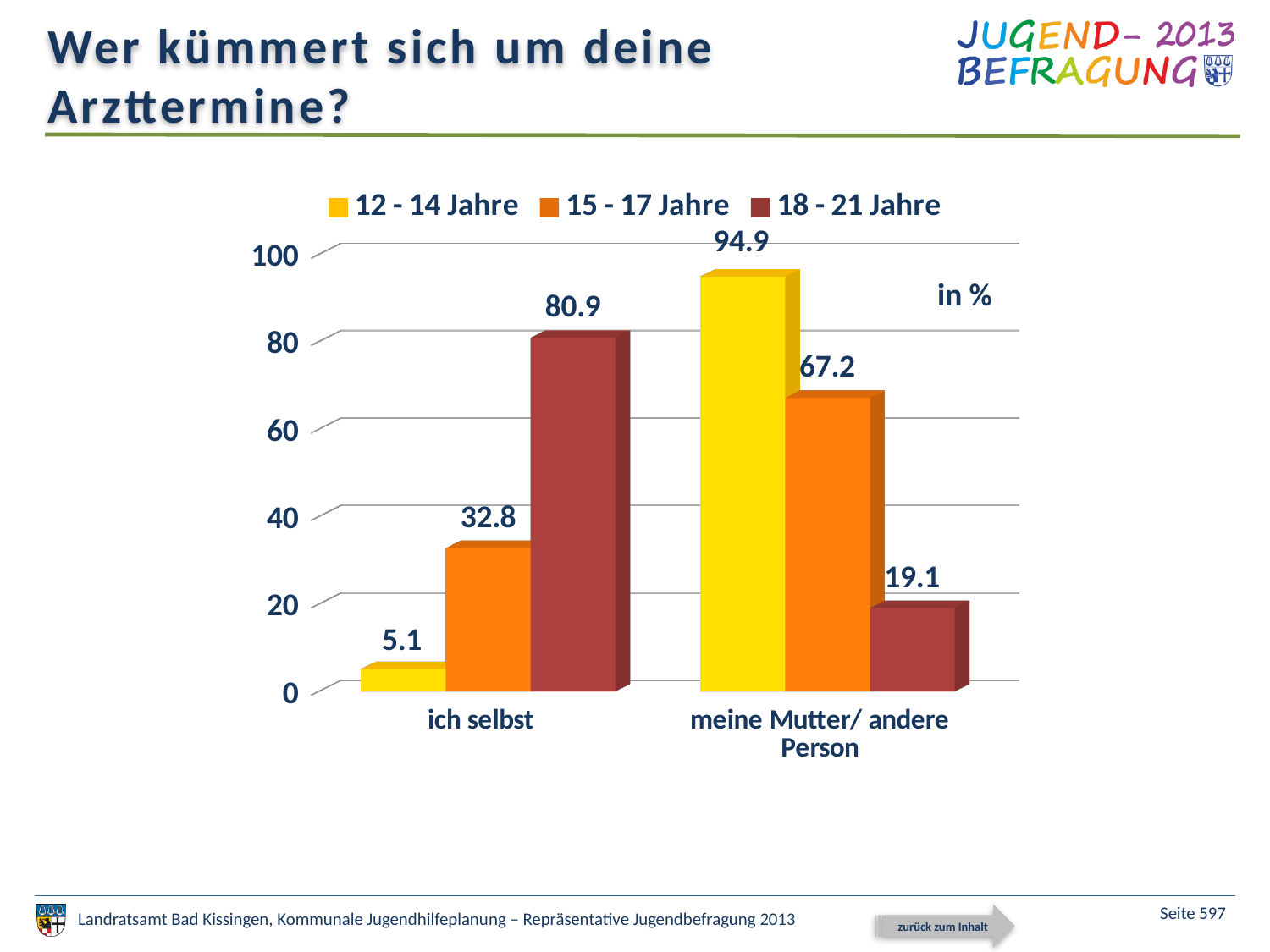
Is the value for '15 - 17 Jahre' in the 'ich selbst' category greater or less than 40? less What kind of chart is shown on the slide? bar chart What is the value for '18 - 21 Jahre' in the 'ich selbst' category? 80.9 How many series does the legend list? 3 Which age group has the highest value in the 'meine Mutter/ andere Person' category? 12 - 14 Jahre What is the value for '15 - 17 Jahre' in the 'meine Mutter/ andere Person' category? 67.2 What is the value for '12 - 14 Jahre' in the 'ich selbst' category? 5.1 What is the difference between the '18 - 21 Jahre' values for 'ich selbst' and 'meine Mutter/ andere Person'? 61.8 How many categories are shown on the x axis? 2 Which age group has the lowest value in the 'ich selbst' category? 12 - 14 Jahre Which is larger: the '15 - 17 Jahre' value for 'ich selbst' or for 'meine Mutter/ andere Person'? meine Mutter/ andere Person What unit is indicated for the values in the chart? in %